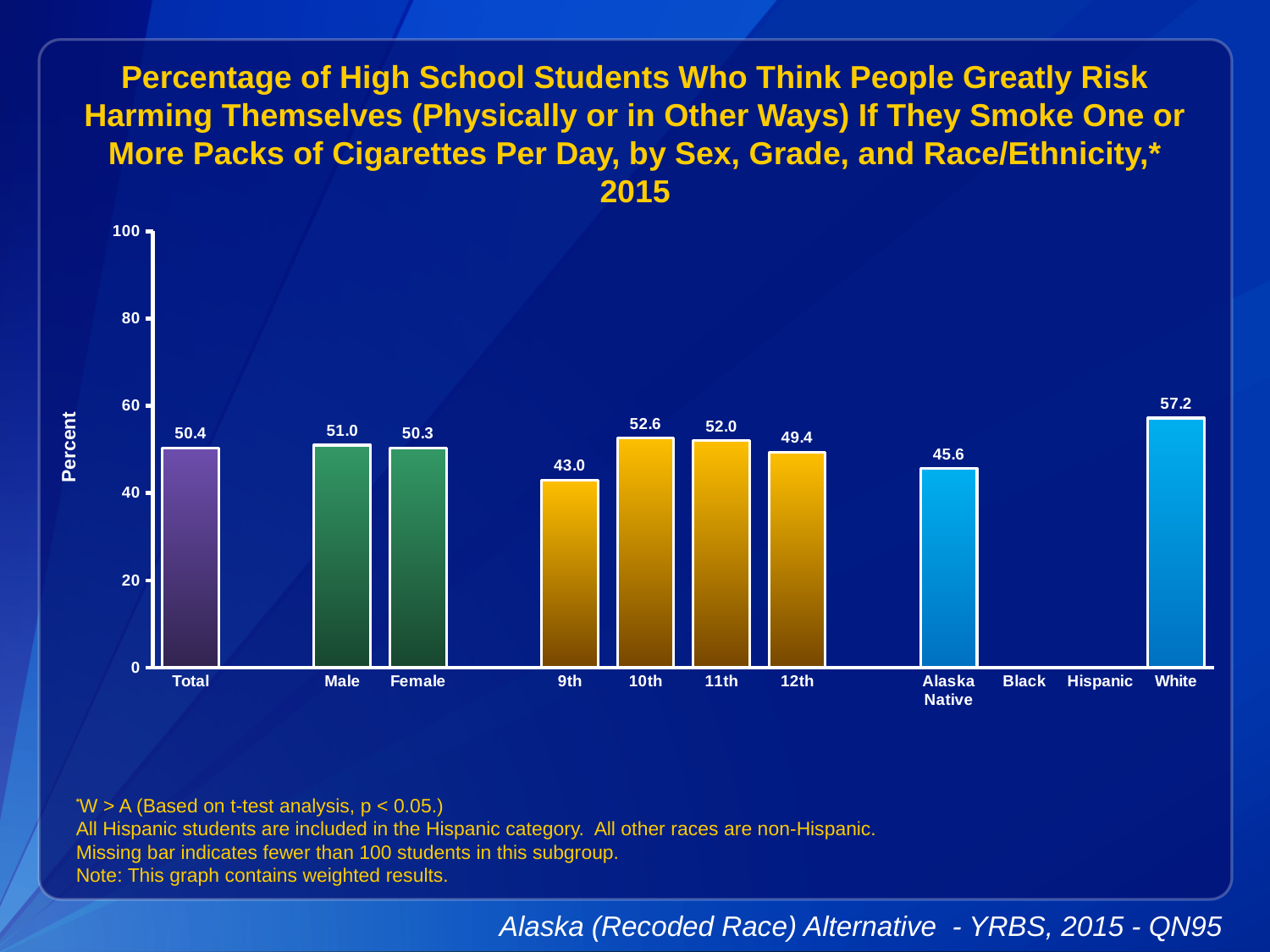
What kind of chart is shown? bar chart What is the difference between the values for White and Alaska Native? 11.6 Which is larger, the value for 10th grade or 12th grade? 10th How many categories have a bar plotted? 9 What is the value for Total? 50.4 What is the value for Alaska Native? 45.6 What is the difference between the values for 10th and 9th grade? 9.6 Is the value for White greater or less than 40? greater Which category has the lowest plotted value? 9th What is the value for 9th grade? 43.0 What is the label on the y axis? Percent Which category has the highest value? White